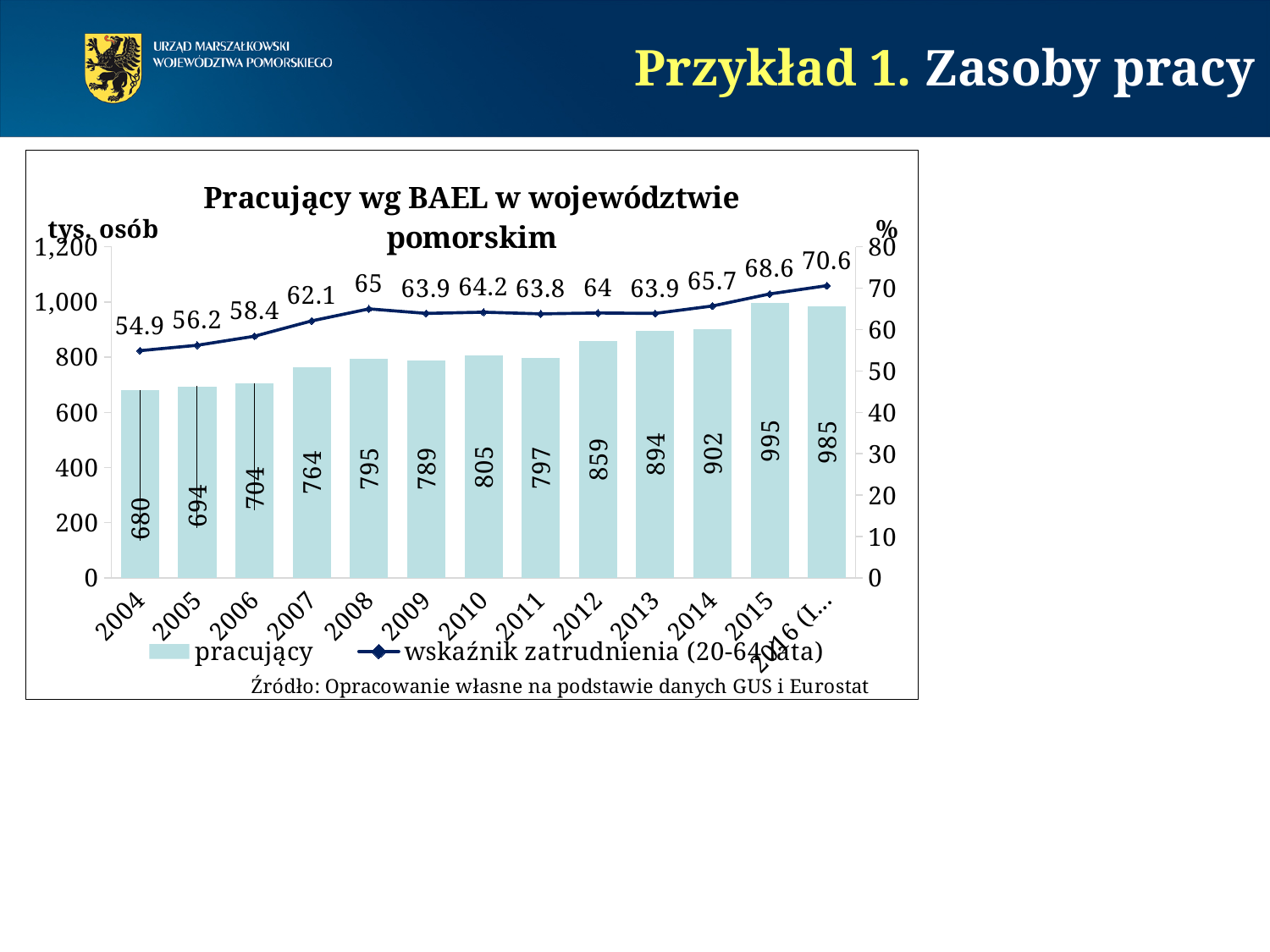
Which year has the larger "pracujący" value, 2008 or 2009? 2008 What is the unit label shown on the left vertical axis? tys. osób In which year is the "wskaźnik zatrudnienia (20-64 lata)" value the lowest? 2004 What is the difference between the "pracujący" values for 2015 and 2004? 315 Does the "wskaźnik zatrudnienia (20-64 lata)" line rise or fall from 2004 to 2008? rise What is the value of "wskaźnik zatrudnienia (20-64 lata)" for 2007? 62.1 In which year is the "pracujący" bar the highest? 2015 Is the "pracujący" value for 2012 greater or less than 800? greater What kind of chart is shown on the slide? Combined bar and line chart What is the value of "pracujący" for 2010? 805 How many series does the legend list? 2 How many categories (years) are shown on the x axis? 13